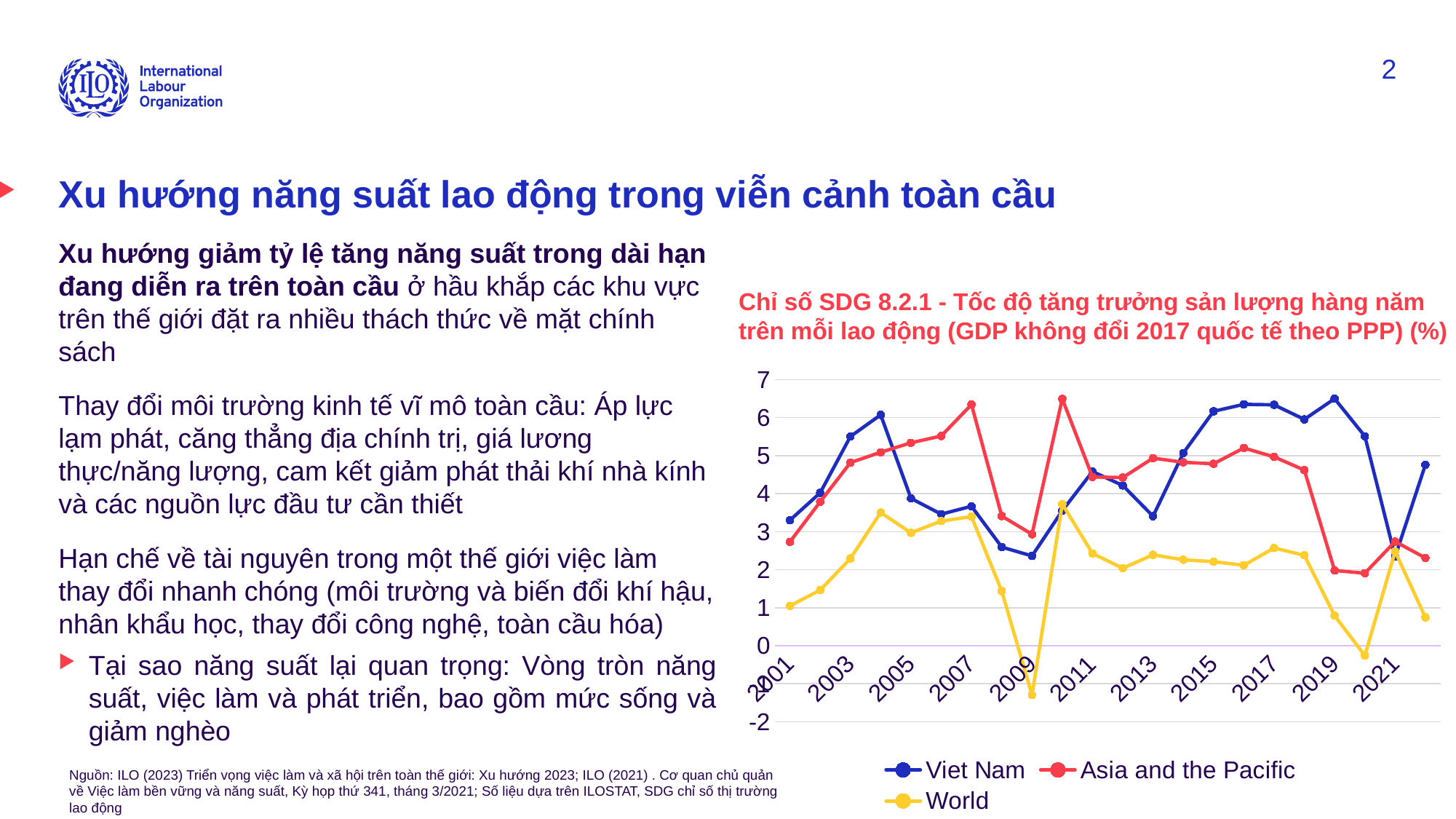
In which year does the World series reach its lowest value? 2009 How many series does the chart's legend list? 3 Is the value for Viet Nam in 2019 greater or less than 6? greater In 2009, which series has the larger value, Viet Nam or World? Viet Nam What colour is the World line in the chart? yellow What kind of chart is shown on the slide? line chart Is the value for World in 2009 greater or less than 0? less Is the value for World in 2001 greater or less than 2? less In 2007, which series has the larger value, Asia and the Pacific or Viet Nam? Asia and the Pacific Which series are listed in the chart's legend? Viet Nam, Asia and the Pacific, World Does the World series rise or fall from 2017 to 2020? fall